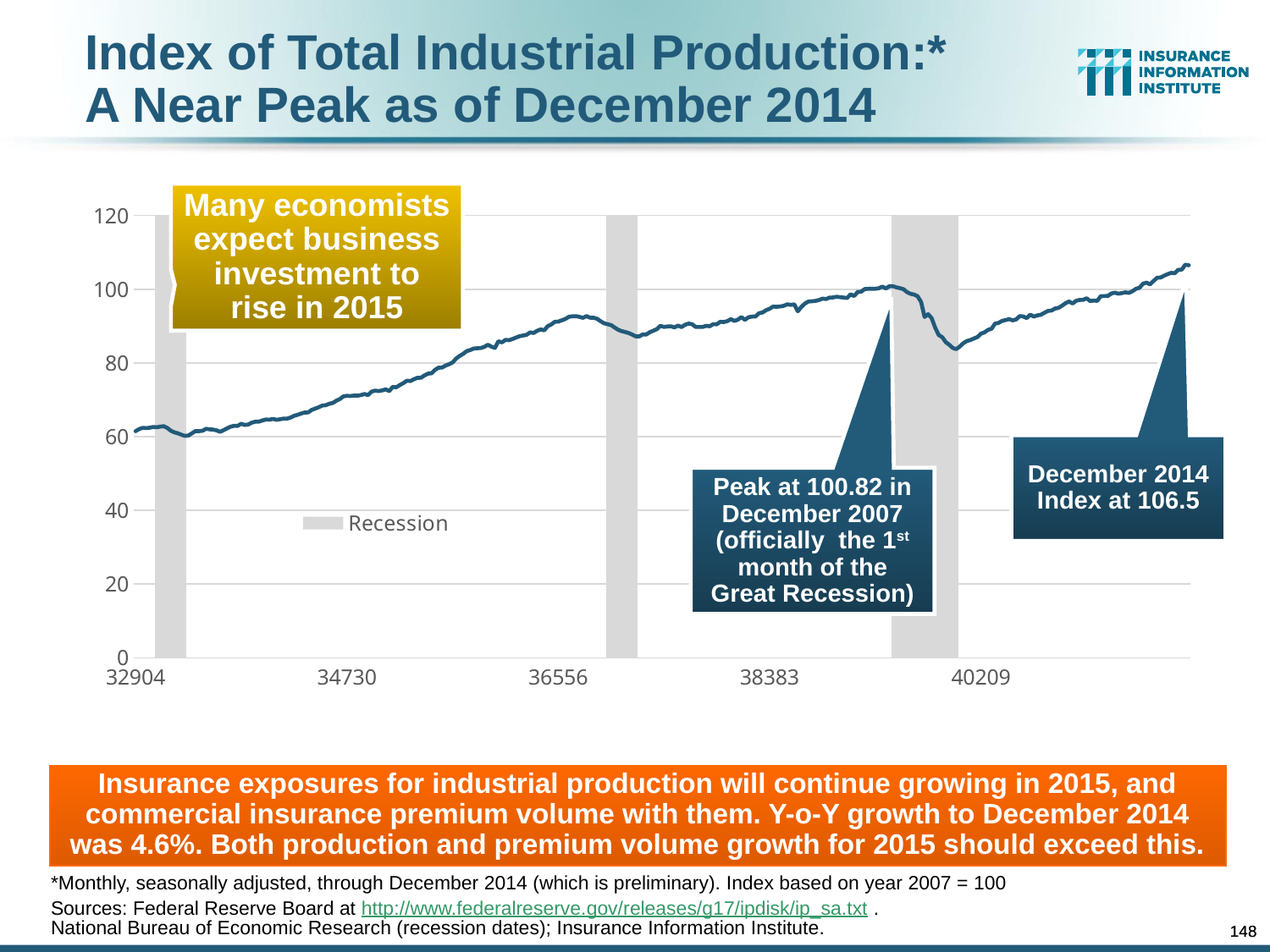
What kind of chart is shown on the slide? line chart Is the index value at the left end of the chart (x = 32904) greater or less than 40? greater Over the whole period shown, does the index generally rise or fall from left to right? rise Is the index value at the left end of the chart (x = 32904) greater or less than 80? less How many shaded recession bands are shown on the chart? 3 According to the callout on the chart, December 2007 was officially the first month of what? the Great Recession What was the Index of Total Industrial Production in December 2014? 106.5 What was the value of the Index of Total Industrial Production at its peak in December 2007? 100.82 Is the index value at x = 36556 greater or less than 80? greater By how much does the December 2014 index value (106.5) exceed the December 2007 peak (100.82)? 5.68 Which is higher: the index in December 2007 or the index in December 2014? December 2014 What does the grey shading in the chart represent, according to the legend? Recession